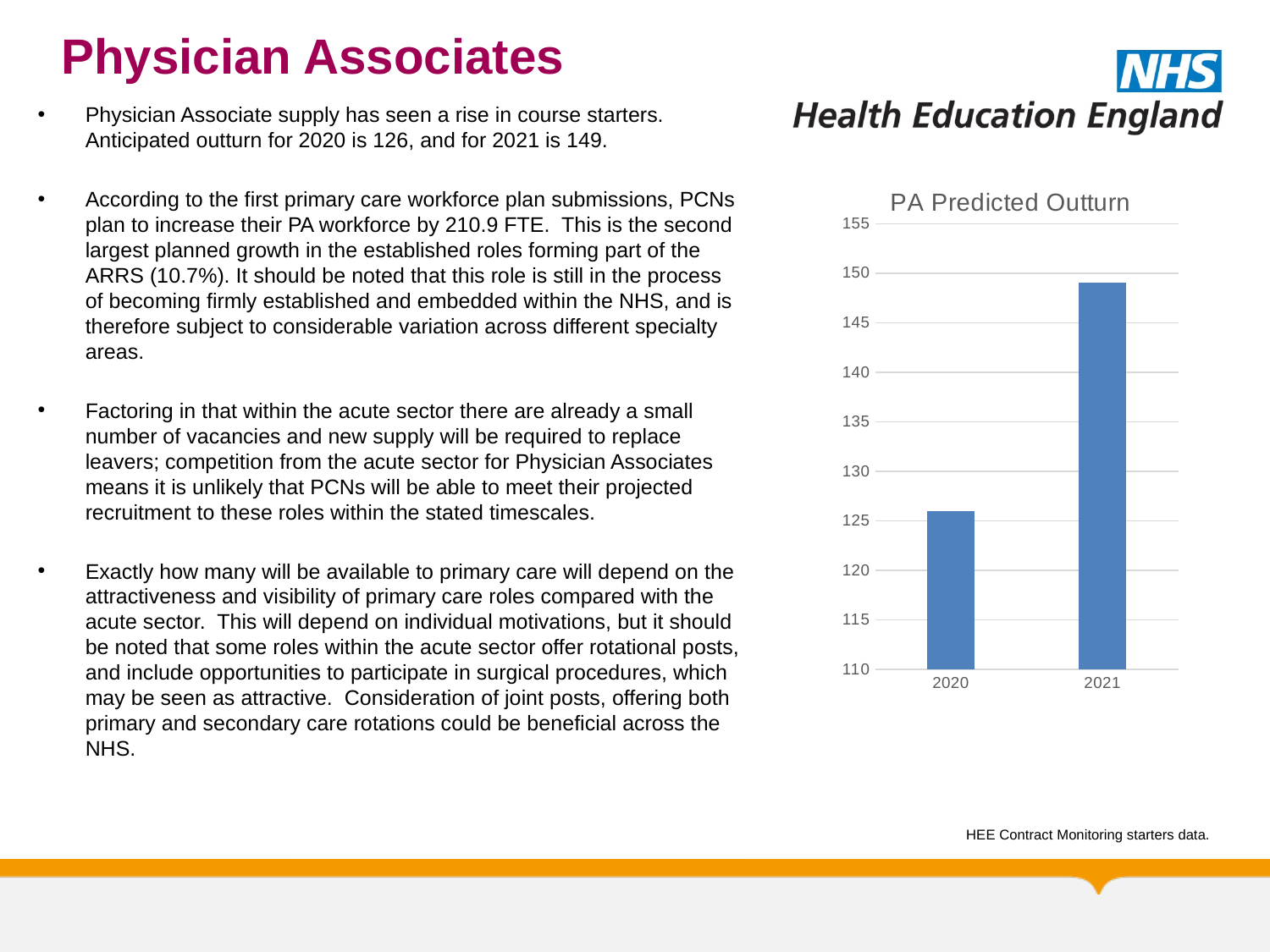
Is the bar for 2021 taller or shorter than the bar for 2020? taller Is the value for 2021 greater or less than 145? greater What kind of chart is shown on the slide? bar chart Which year has the higher predicted outturn in the chart? 2021 Is the value for 2020 greater or less than 120? greater How many bars are plotted in the PA Predicted Outturn chart? 2 Do the values rise or fall from 2020 to 2021? rise What is the title of the chart? PA Predicted Outturn What is the lowest value shown on the vertical axis of the chart? 110 Which year has the lower predicted outturn in the chart? 2020 Is the value for 2020 greater or less than 130? less